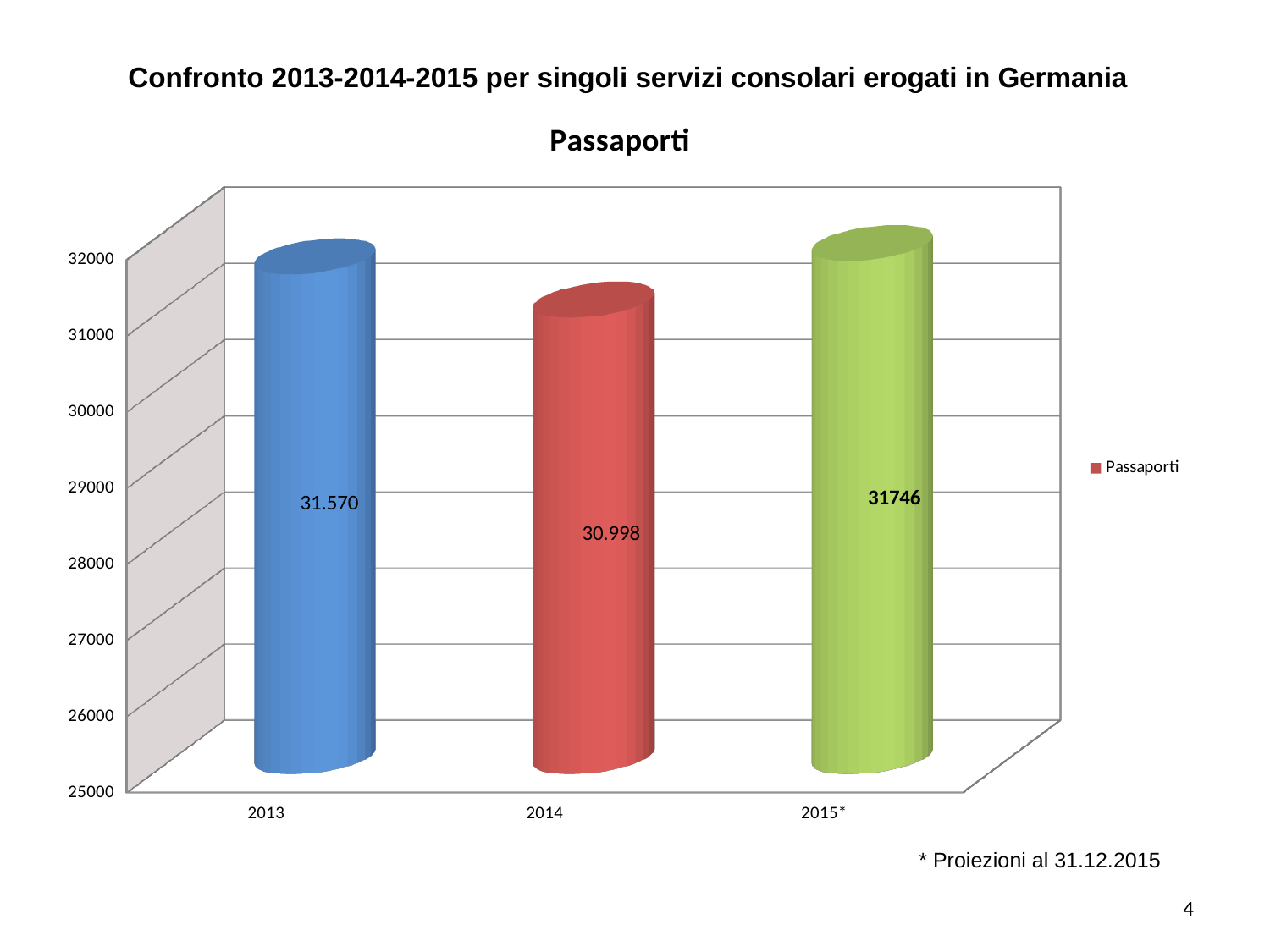
What kind of chart is the Passaporti chart? bar chart Is the value for 2013 in the Passaporti chart greater or less than 31000? greater What is the value for 2013 in the Passaporti chart? 31.570 How many series does the legend of the Passaporti chart list? 1 Which is larger in the Passaporti chart, the value for 2013 or the value for 2014? 2013 Which year has the highest value in the Passaporti chart? 2015* Which year has the lowest value in the Passaporti chart? 2014 What is the value for 2014 in the Passaporti chart? 30.998 How many years are shown on the x axis of the Passaporti chart? 3 What is the value for 2015* in the Passaporti chart? 31746 What is the difference between the 2013 and 2014 values in the Passaporti chart? 572 What is the difference between the 2015* and 2014 values in the Passaporti chart? 748